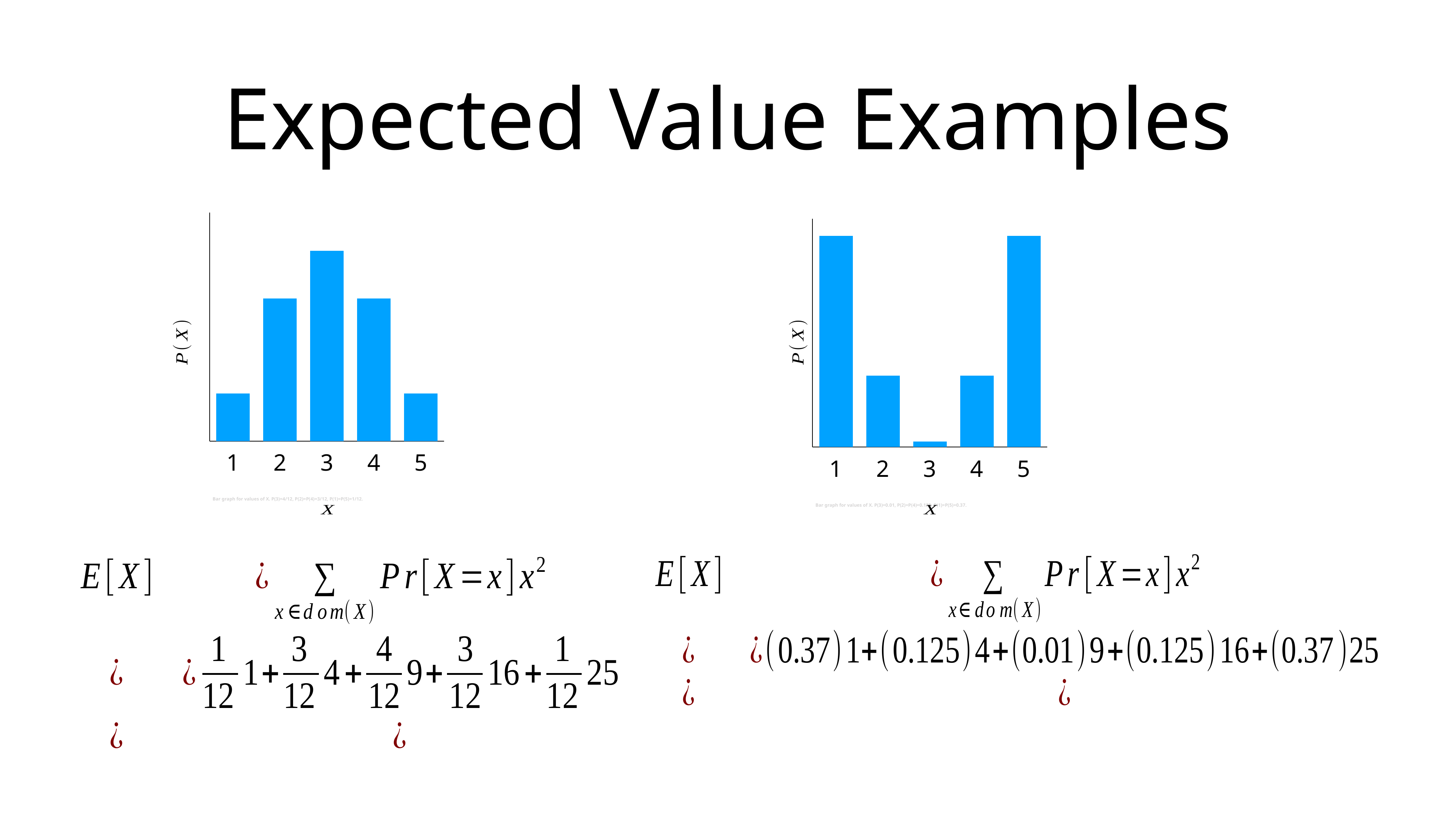
What kind of chart is the left chart? bar chart In the right chart, which value of x has the lowest bar? 3 In the left chart, do the bars rise or fall from x = 1 to x = 3? rise In the left chart, which bar is taller: x = 2 or x = 5? 2 How many bars does the left chart have? 5 In the right chart, do the bars rise or fall from x = 1 to x = 3? fall In the right chart, is the bar for x = 4 taller or shorter than the bar for x = 3? taller In the left chart, which value of x has the highest bar? 3 In the left chart, is the bar for x = 3 taller or shorter than the bar for x = 1? taller How many bars does the right chart have? 5 What is the label on the vertical axis of the right chart? P(X)